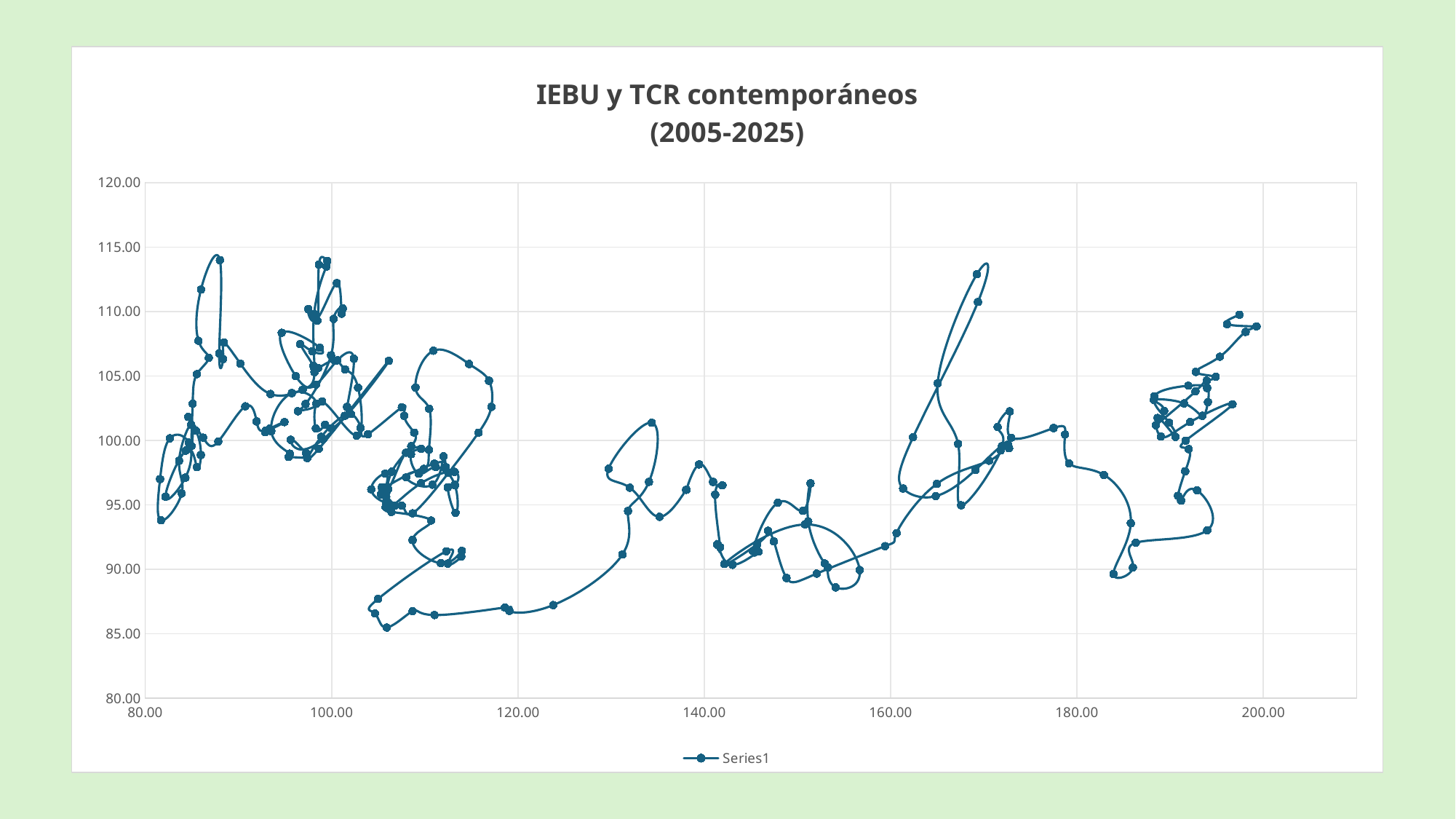
Is the lowest y value plotted on the chart greater or less than 90.00? less What is the title of the chart? IEBU y TCR contemporáneos (2005-2025) Is the highest y value plotted on the chart greater or less than 110.00? greater What is the name of the series shown in the legend? Series1 How many series does the legend list? 1 Is the lowest y value plotted on the chart greater or less than 85.00? greater What kind of chart is shown on the slide? scatter chart